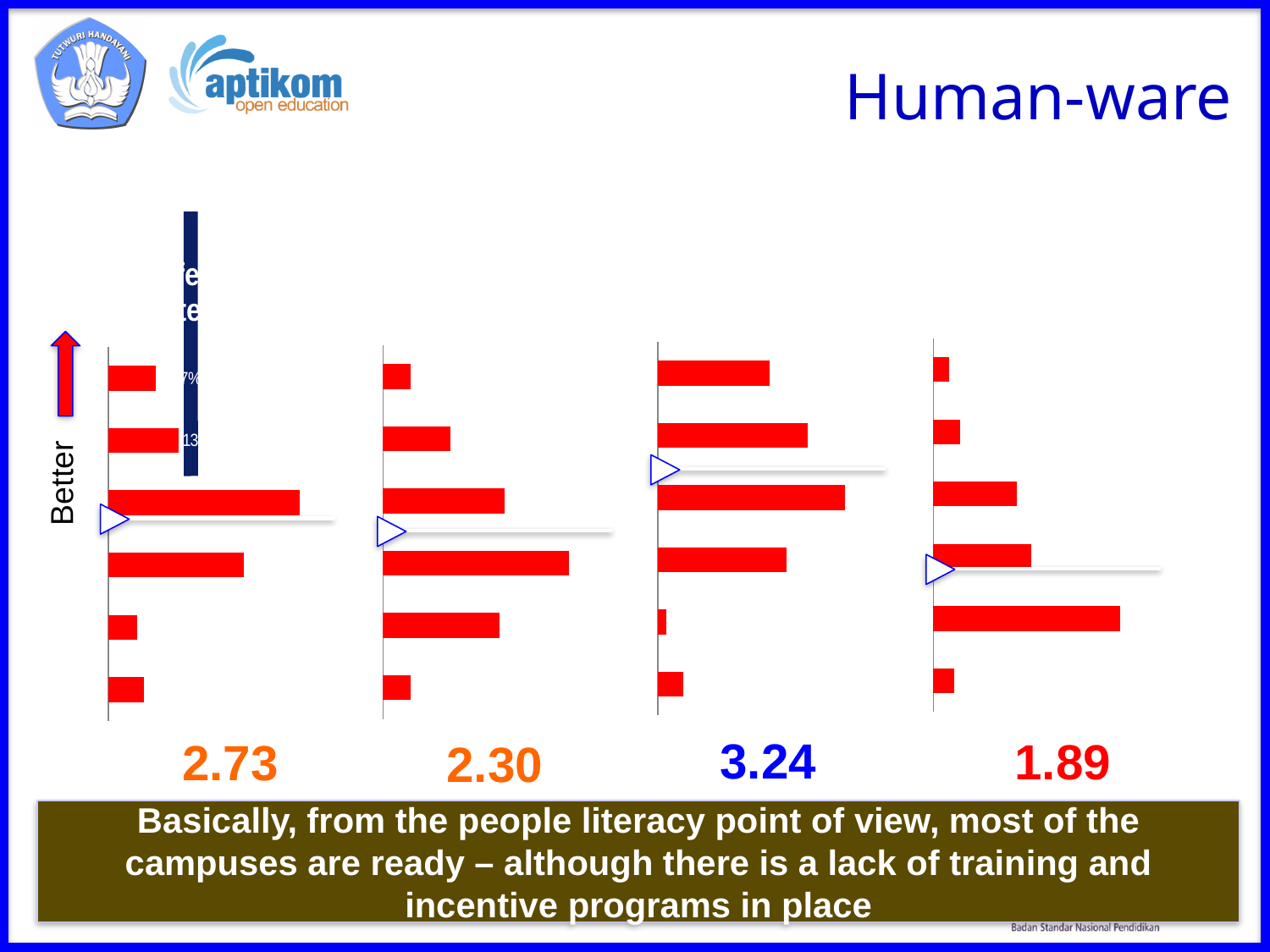
Which chart has the lowest score printed beneath it, and what is that score? the rightmost chart, 1.89 In the third chart from the left, which bar (counting from the top) is the longest? the third bar What kind of chart is used on this slide? bar chart Is the score printed below the leftmost chart (2.73) larger or smaller than the score below the second chart (2.30)? larger What score is printed below the third chart from the left? 3.24 How many separate bar charts are shown on the slide? 4 How many bars does the rightmost chart contain? 6 In the leftmost chart, which bar (counting from the top) is the longest? the third bar How many bars does the leftmost chart contain? 6 In the second chart from the left, which bar (counting from the top) is the longest? the fourth bar In the third chart from the left, which bar (counting from the top) is the shortest? the fifth bar